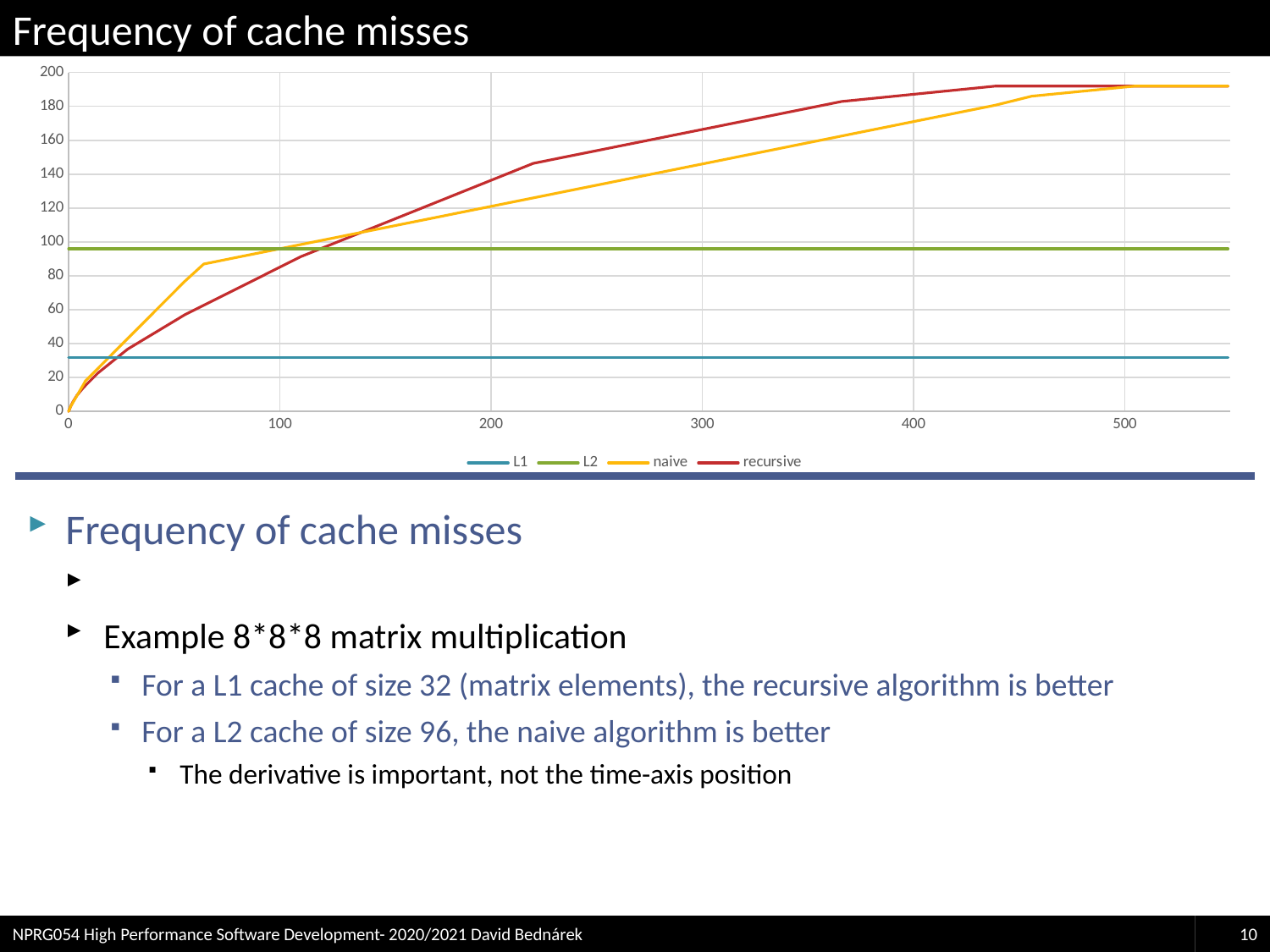
Which series are listed in the chart legend? L1, L2, naive, recursive Which two series are drawn as horizontal lines on the chart? L1 and L2 Is the value of the L2 line greater or less than 80? greater At x = 300, which series has the higher value, naive or recursive? recursive Is the value of the L1 line greater or less than 40? less What kind of chart is shown on the slide? line chart Does the naive series rise or fall as x increases from 0 to 500? rise How many series does the chart legend list? 4 At x = 50, which series has the higher value, naive or recursive? naive Is the value of the recursive series at x = 300 greater or less than 140? greater